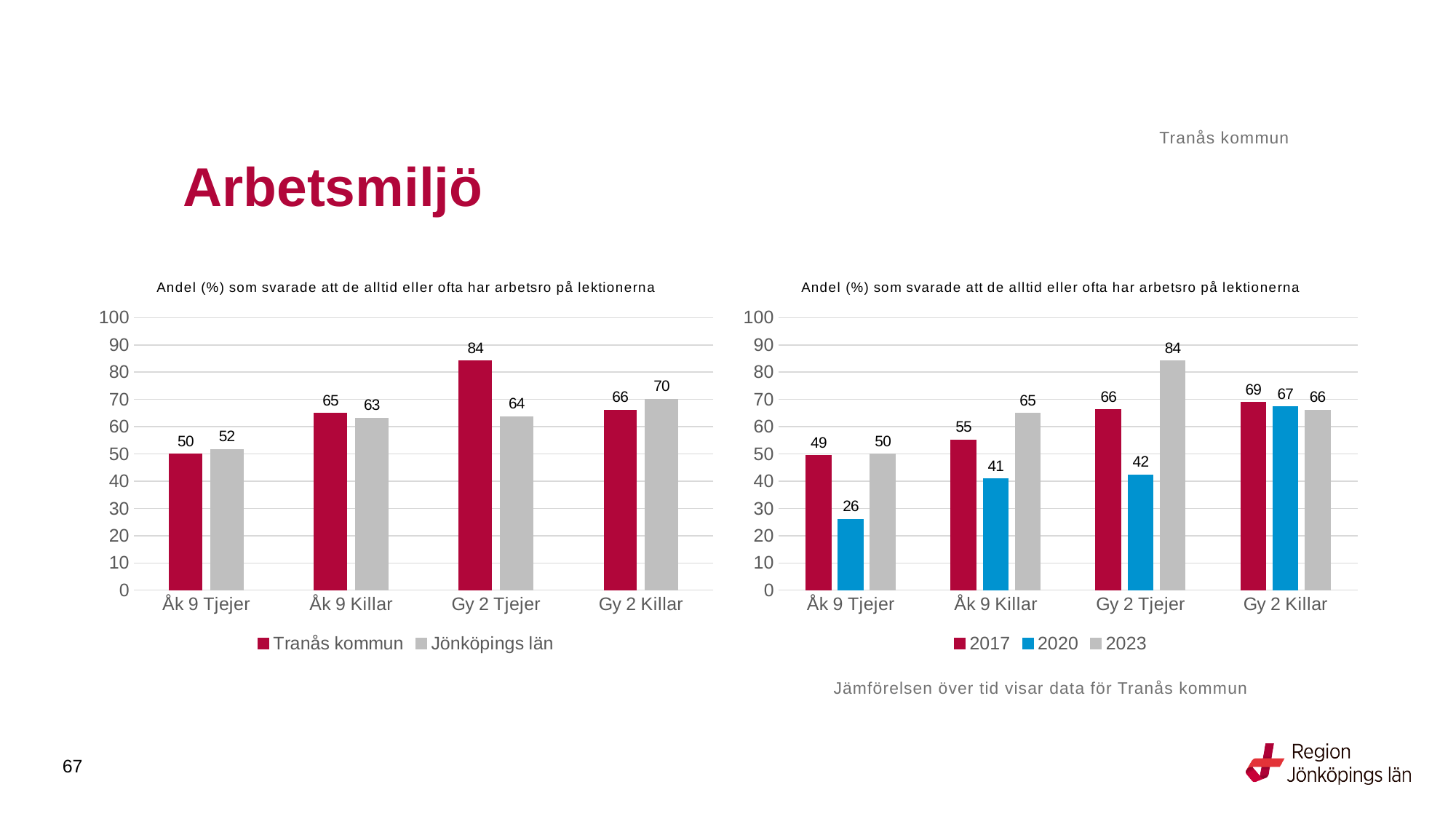
In the right chart, which category has the lowest value for 2020? Åk 9 Tjejer In the right chart, what is the value for 2023 for Åk 9 Killar? 65 In the right chart, what is the difference between the 2023 and 2020 values for Gy 2 Tjejer? 42 In the right chart, what is the value for 2020 for Åk 9 Tjejer? 26 In the left chart, what is the value for Jönköpings län for Gy 2 Killar? 70 In the left chart, how many series does the legend list? 2 In the left chart, what is the value for Tranås kommun for Gy 2 Tjejer? 84 In the right chart, which is larger for Gy 2 Tjejer: the 2017 value or the 2023 value? 2023 In the left chart, which category has the highest value for Tranås kommun? Gy 2 Tjejer In the right chart, how many categories are shown on the x axis? 4 What kind of chart is the right chart? Bar chart In the left chart, what is the difference between Tranås kommun and Jönköpings län for Gy 2 Tjejer? 20